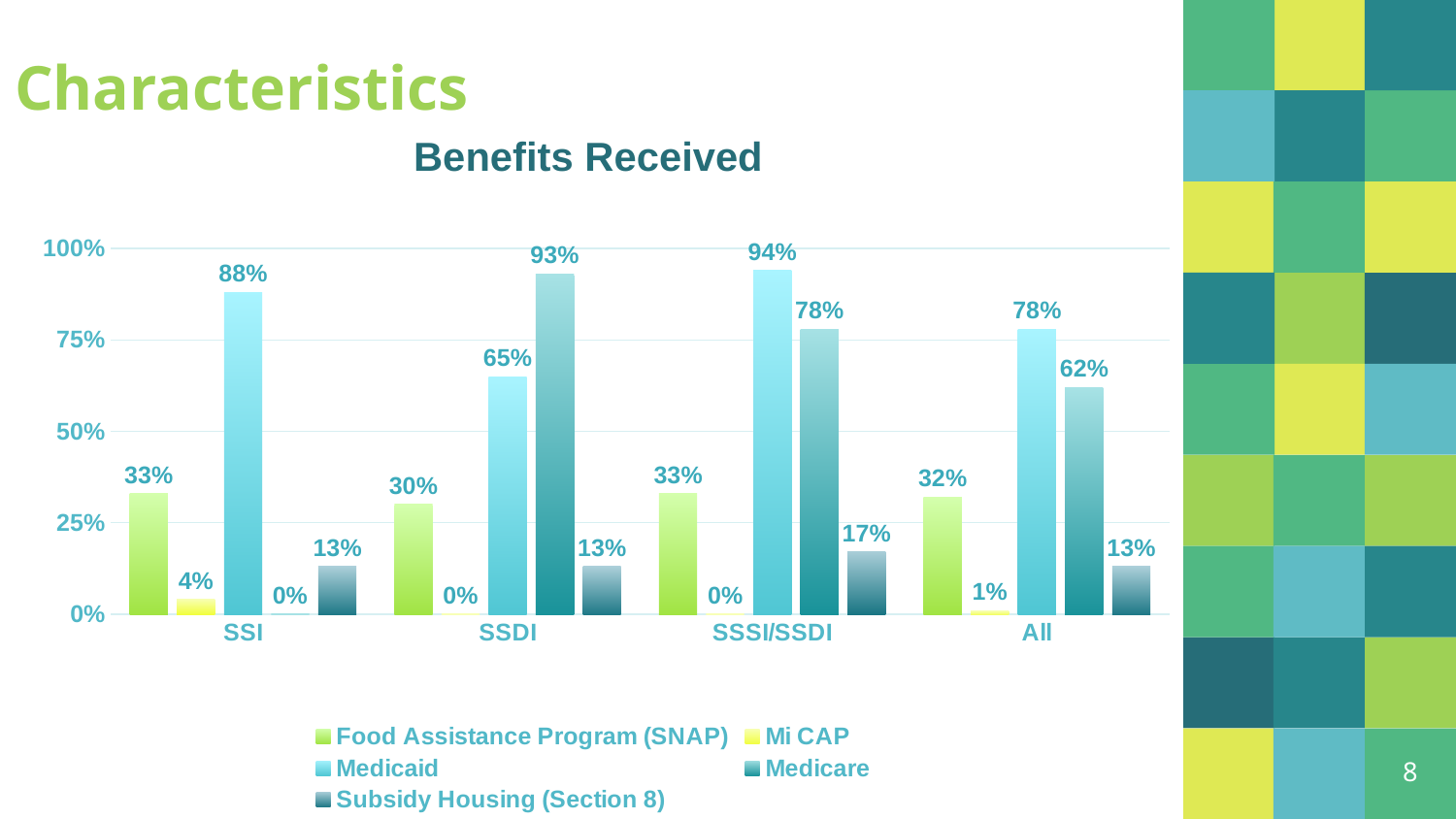
What is the Subsidy Housing (Section 8) value for the SSSI/SSDI category? 17% How many categories are shown on the x axis? 4 Which category has the highest Medicaid value? SSSI/SSDI Which category has the lowest Medicare value? SSI What kind of chart is shown on the slide? bar chart Which is larger for the SSDI category, Medicaid or Medicare? Medicare What is the difference between the Medicaid and Medicare values for the All category? 16% How many series does the legend list? 5 What is the Medicaid value for the SSI category? 88% What is the Medicare value for the SSDI category? 93% What is the Mi CAP value for the All category? 1% Is the Food Assistance Program (SNAP) value for SSDI greater or less than 50%? less